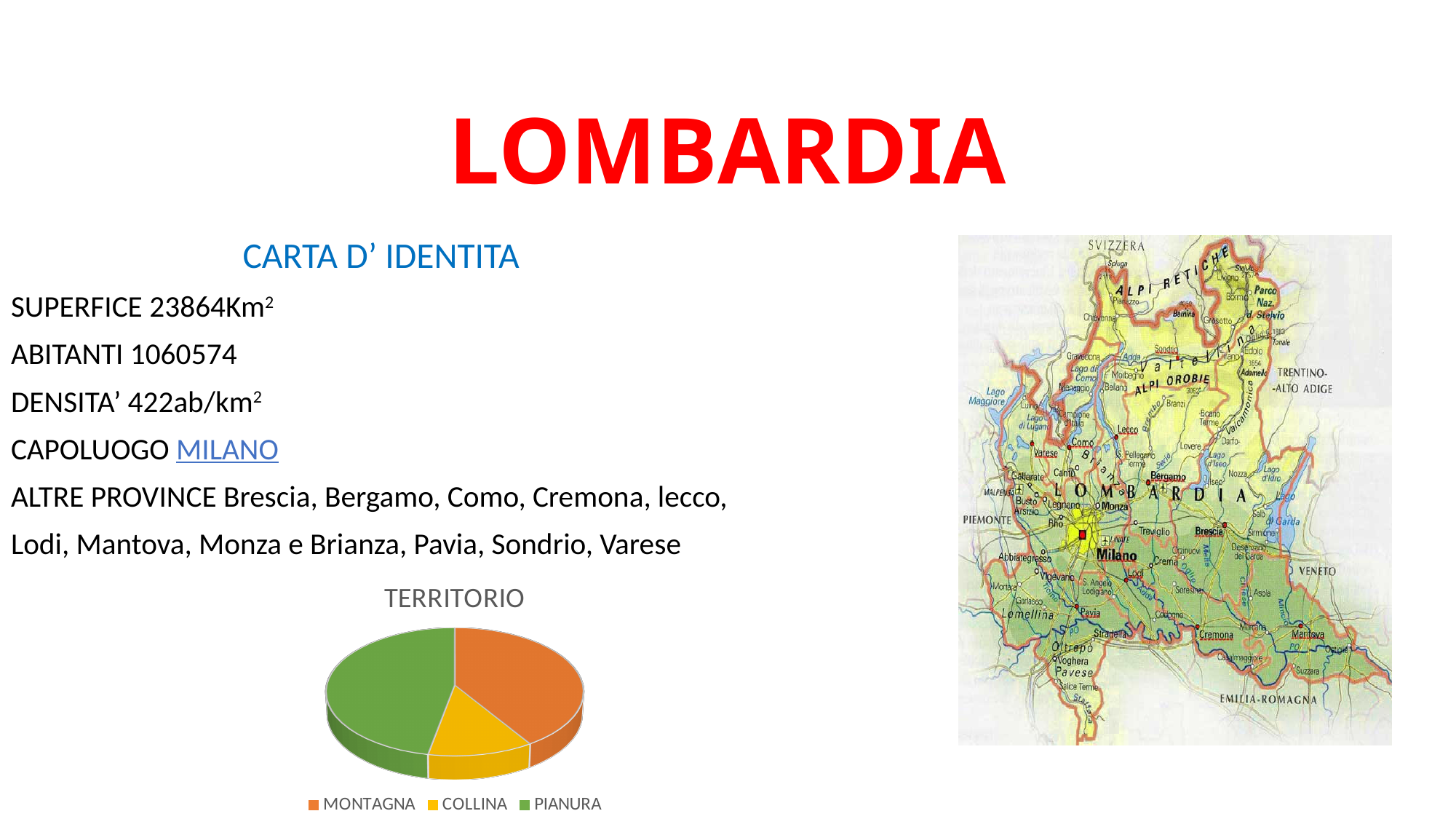
In the TERRITORIO pie chart, which slice is larger, PIANURA or COLLINA? PIANURA How many entries does the legend of the TERRITORIO pie chart list? 3 Which category has the smallest slice in the TERRITORIO pie chart? COLLINA Which category has the largest slice in the TERRITORIO pie chart? PIANURA In the TERRITORIO pie chart, which slice is larger, MONTAGNA or COLLINA? MONTAGNA Which categories are listed in the legend of the TERRITORIO pie chart? MONTAGNA, COLLINA, PIANURA What colour represents MONTAGNA in the TERRITORIO pie chart? orange What is the title of the pie chart on the slide? TERRITORIO What kind of chart is shown under the heading TERRITORIO? pie chart How many slices does the TERRITORIO pie chart have? 3